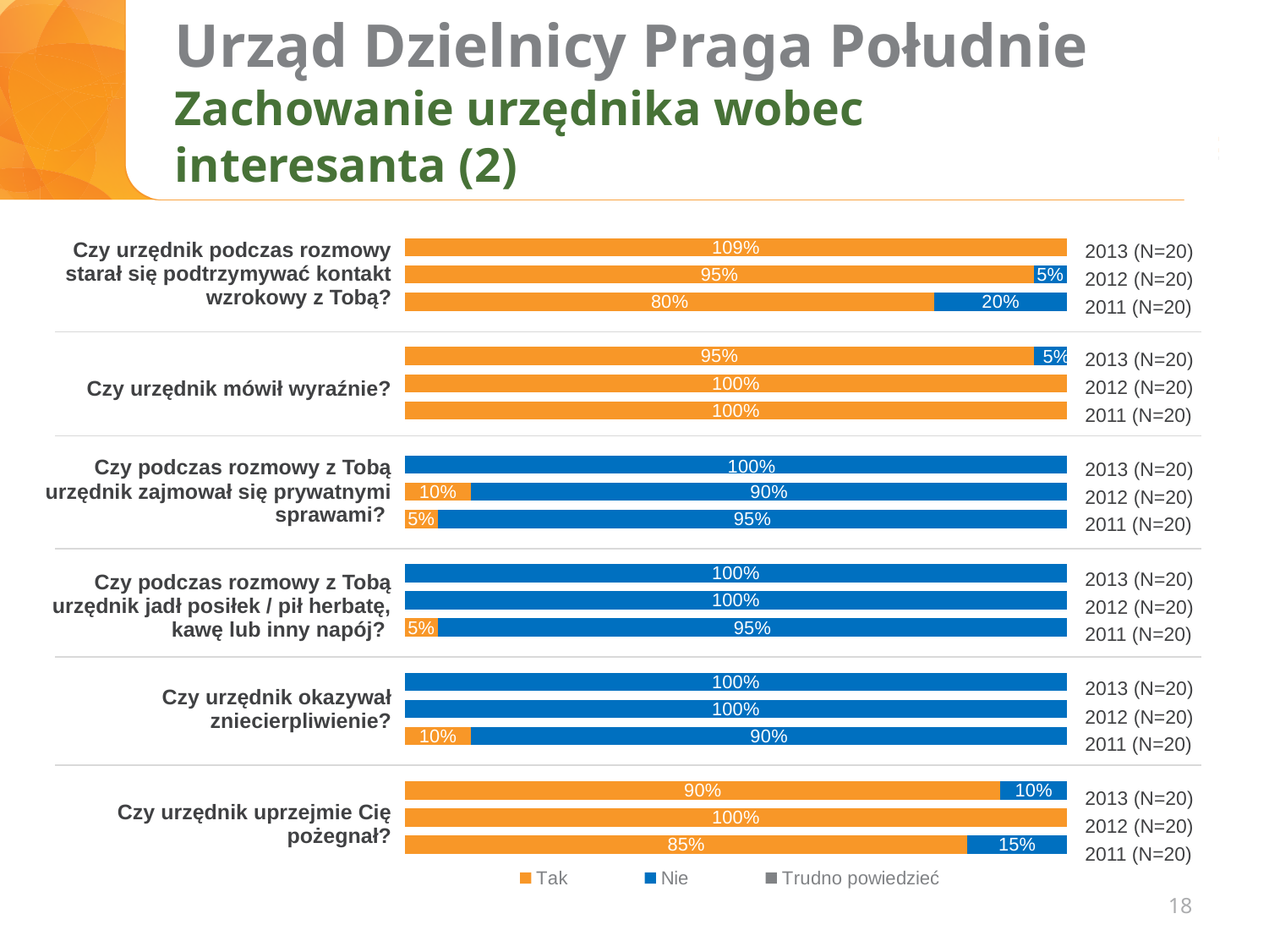
For the question "Czy urzędnik podczas rozmowy starał się podtrzymywać kontakt wzrokowy z Tobą?", what percentage answered "Nie" in 2011? 20% For the question "Czy podczas rozmowy z Tobą urzędnik zajmował się prywatnymi sprawami?", what percentage answered "Tak" in 2012? 10% For the question "Czy urzędnik mówił wyraźnie?", what percentage answered "Tak" in 2013? 95% What are the legend entries of the chart? Tak, Nie, Trudno powiedzieć How many series does the legend list? 3 For the question "Czy podczas rozmowy z Tobą urzędnik jadł posiłek / pił herbatę, kawę lub inny napój?", what percentage answered "Nie" in 2011? 95% What kind of chart is shown on the slide? Stacked bar chart For the question "Czy urzędnik uprzejmie Cię pożegnał?", what percentage answered "Nie" in 2011? 15% For the question "Czy urzędnik uprzejmie Cię pożegnał?", which year had a higher "Tak" share, 2013 or 2011? 2013 For the question "Czy urzędnik okazywał zniecierpliwienie?", what percentage answered "Tak" in 2011? 10% For the question "Czy urzędnik podczas rozmowy starał się podtrzymywać kontakt wzrokowy z Tobą?", what is the difference between the "Tak" and "Nie" shares in 2011? 60 percentage points How many years (bars) are shown for each survey question? 3